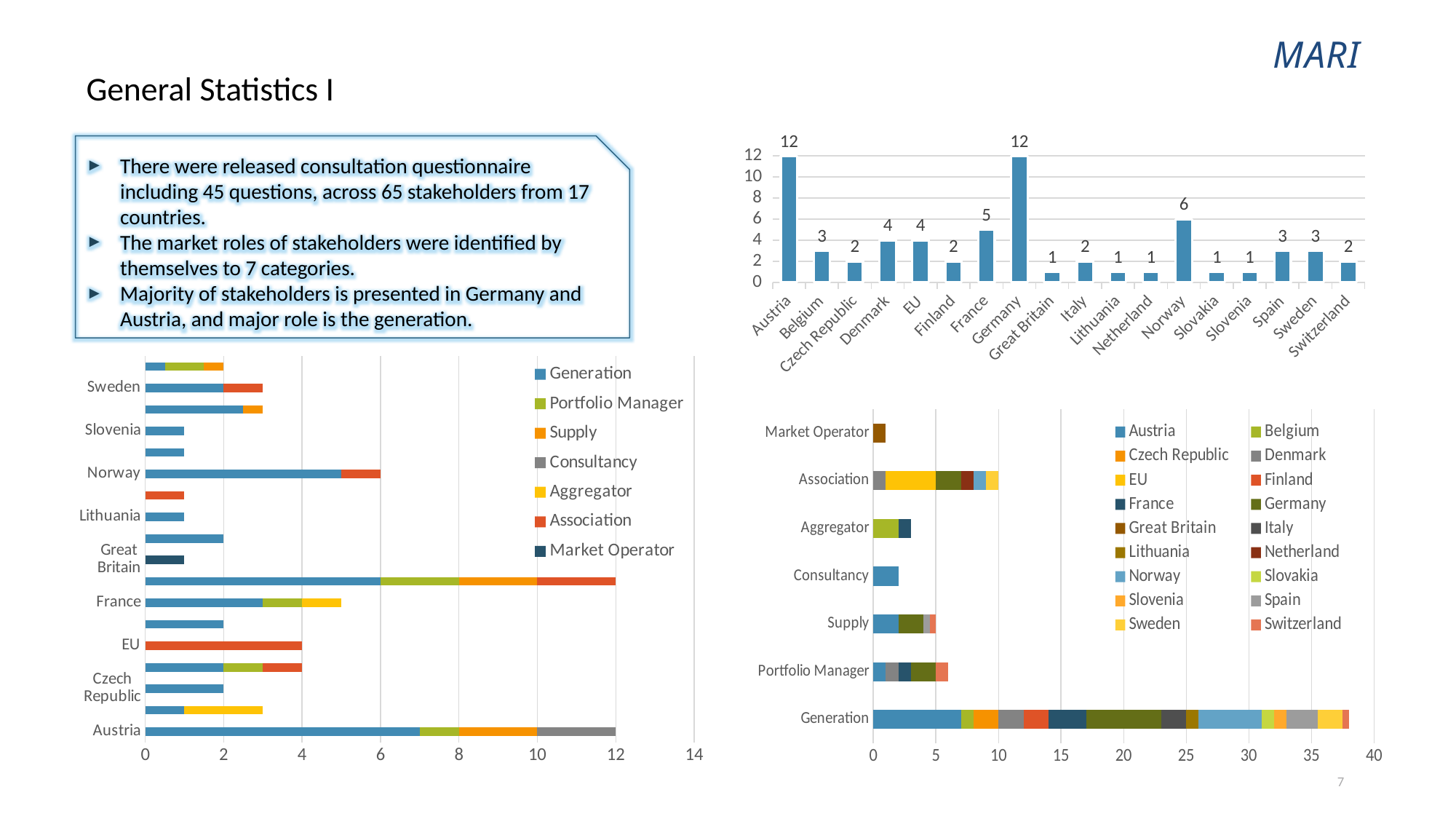
In the top-right bar chart, which has the larger value, Denmark or Finland? Denmark In the bottom-right chart, is the total length of the Generation bar greater or less than 35? greater How many series does the legend of the bottom-left chart list? 7 In the top-right bar chart, what is the value for Sweden? 3 In the top-right bar chart, what is the value for France? 5 In the top-right bar chart, what is the highest value shown? 12 Which series is shown in orange in the legend of the bottom-left chart? Supply How many countries are shown on the x axis of the top-right bar chart? 18 In the top-right bar chart, what is the value for Norway? 6 What kind of chart is the top-right chart? bar chart In the top-right bar chart, what is the difference between the values for Austria and Belgium? 9 In the bottom-left chart, is the total length of the Austria bar greater or less than 10? greater